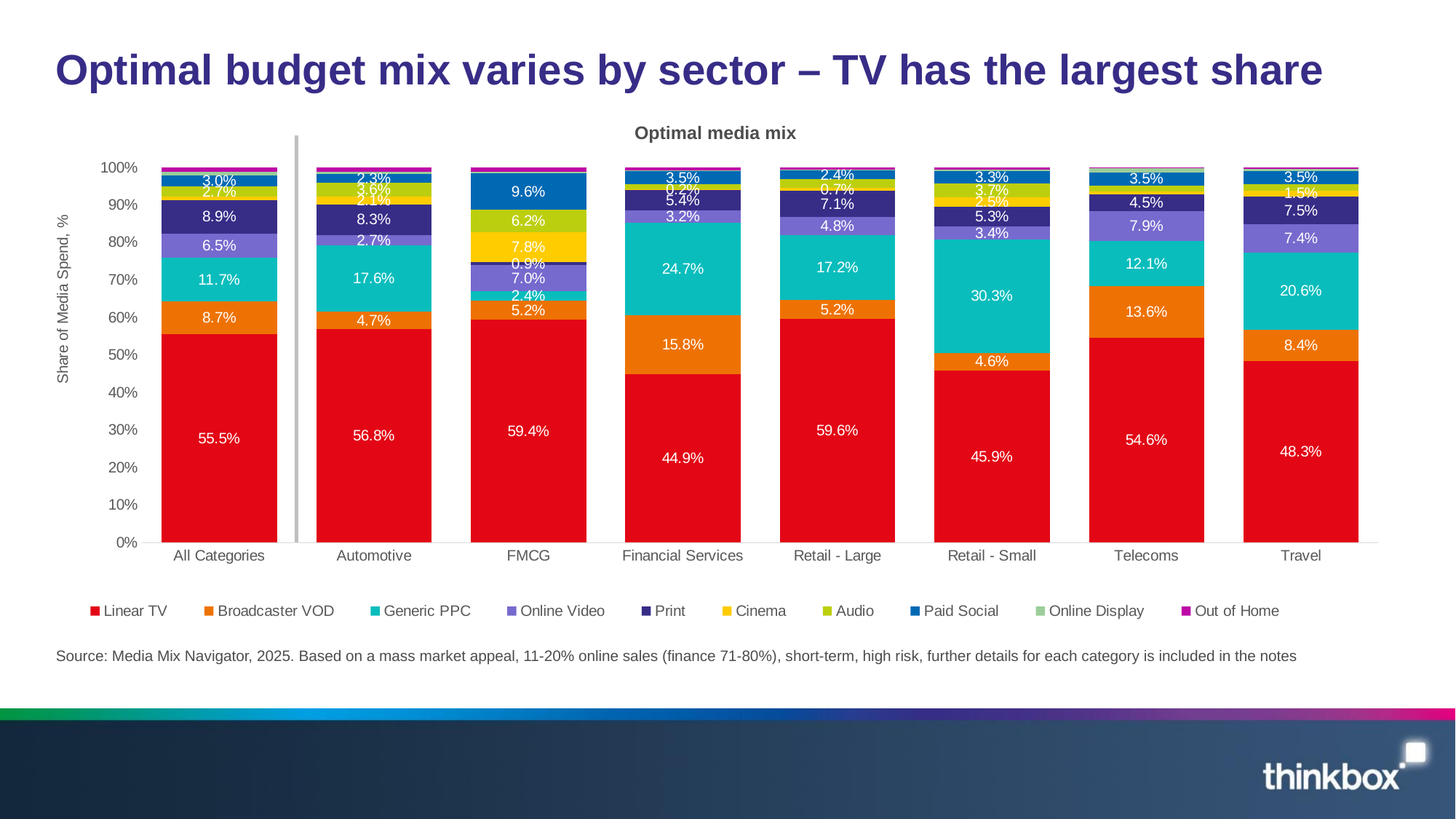
What is the title of the y axis on the chart? Share of Media Spend, % What is the Broadcaster VOD share for Financial Services? 15.8% How many series does the legend of the Optimal media mix chart list? 10 What is the Linear TV share for Telecoms? 54.6% How many sector categories are shown along the x axis of the Optimal media mix chart? 8 What is the difference between the Broadcaster VOD share for Telecoms and for Automotive? 8.9 percentage points What is the Generic PPC share for Financial Services? 24.7% Is the Linear TV share for Retail - Small greater or less than 50%? less What kind of chart is shown on the slide? Stacked bar chart What is the Paid Social share for FMCG? 9.6% Which sector has the highest Generic PPC share? Retail - Small Which has the larger Linear TV share, Travel or Financial Services? Travel